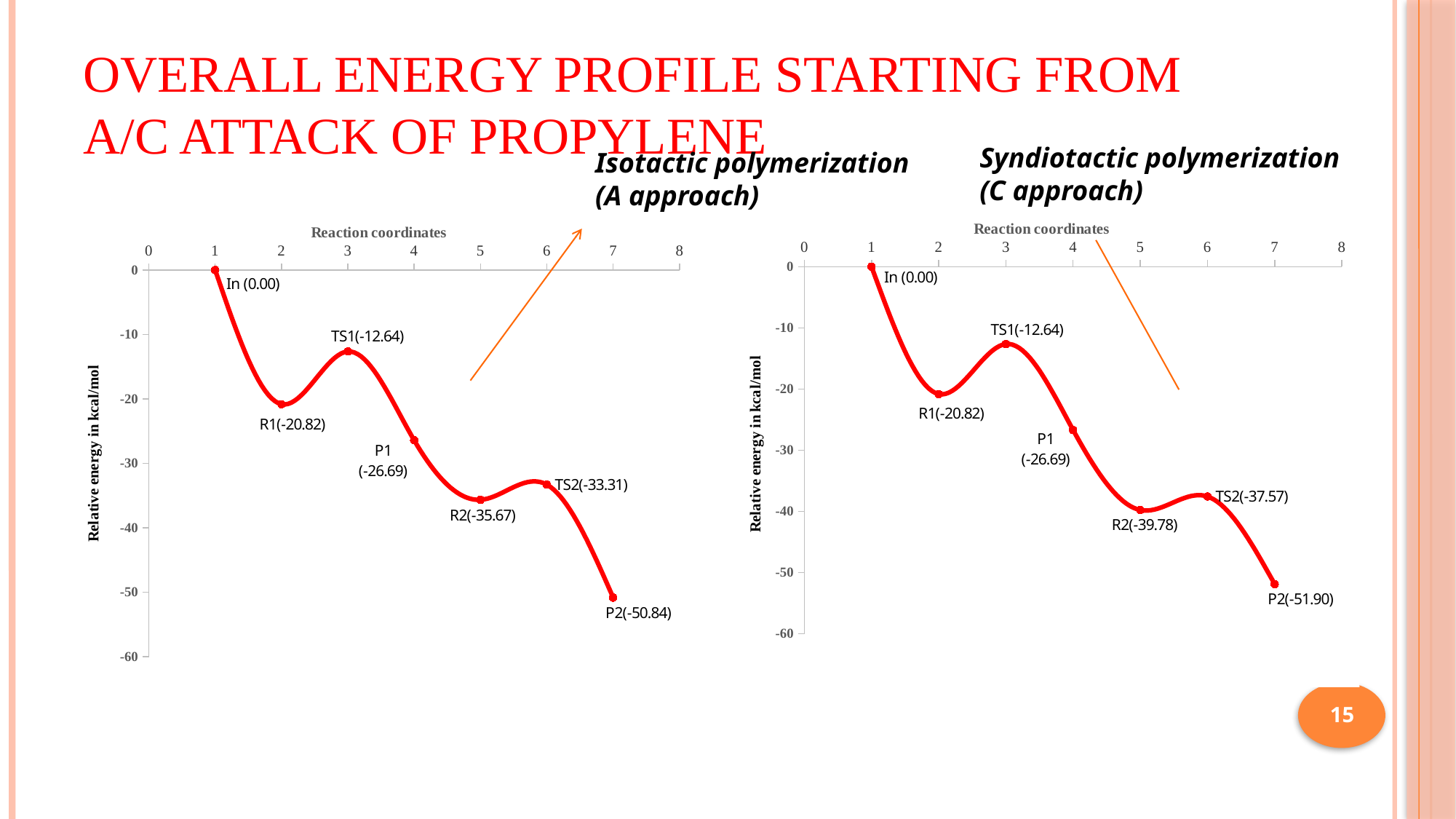
In the Syndiotactic polymerization (C approach) chart, what is the relative energy of R2? -39.78 In the Isotactic polymerization (A approach) chart, what is the difference in relative energy between R1 and TS1? 8.18 In the Isotactic polymerization (A approach) chart, what is the relative energy of P2? -50.84 Which chart shows a lower relative energy for P2, the Isotactic (A approach) chart or the Syndiotactic (C approach) chart? Syndiotactic (C approach) What kind of chart is the Syndiotactic polymerization (C approach) chart? Line chart In the Isotactic polymerization (A approach) chart, what is the relative energy of TS1? -12.64 In the Syndiotactic polymerization (C approach) chart, which labeled point has the highest relative energy? In In the Syndiotactic polymerization (C approach) chart, is the value for P1 greater or less than -30? greater What is the y-axis title of the Isotactic polymerization (A approach) chart? Relative energy in kcal/mol In the Isotactic polymerization (A approach) chart, which labeled point has the lowest relative energy? P2 In the Syndiotactic polymerization (C approach) chart, what is the relative energy of TS2? -37.57 How many labeled data points are plotted in the Isotactic polymerization (A approach) chart? 7